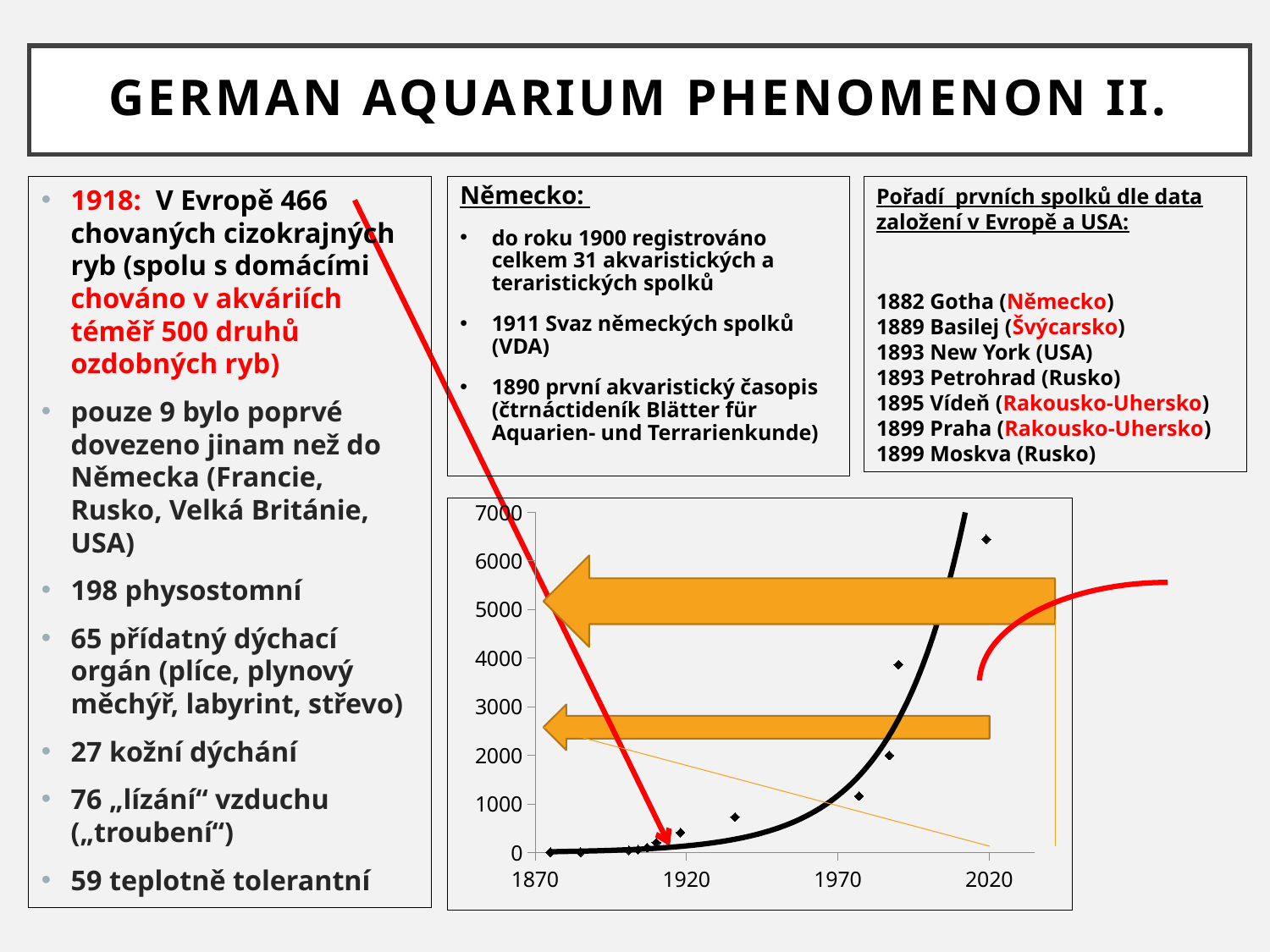
What is the first year label shown on the chart's horizontal axis? 1870 What kind of chart is shown at the bottom right of the slide? scatter chart Are the plotted points before 1900 greater or less than 1000? less What is the highest value shown on the chart's vertical axis? 7000 Is the value of the highest plotted point in the chart greater or less than 6000? greater Do the plotted values in the chart rise or fall as the years increase along the x axis? rise Is the value of the plotted point near 1920 greater or less than 1000? less Which plotted point has the highest value: the one near 2010 or the one near 2020? the one near 2020